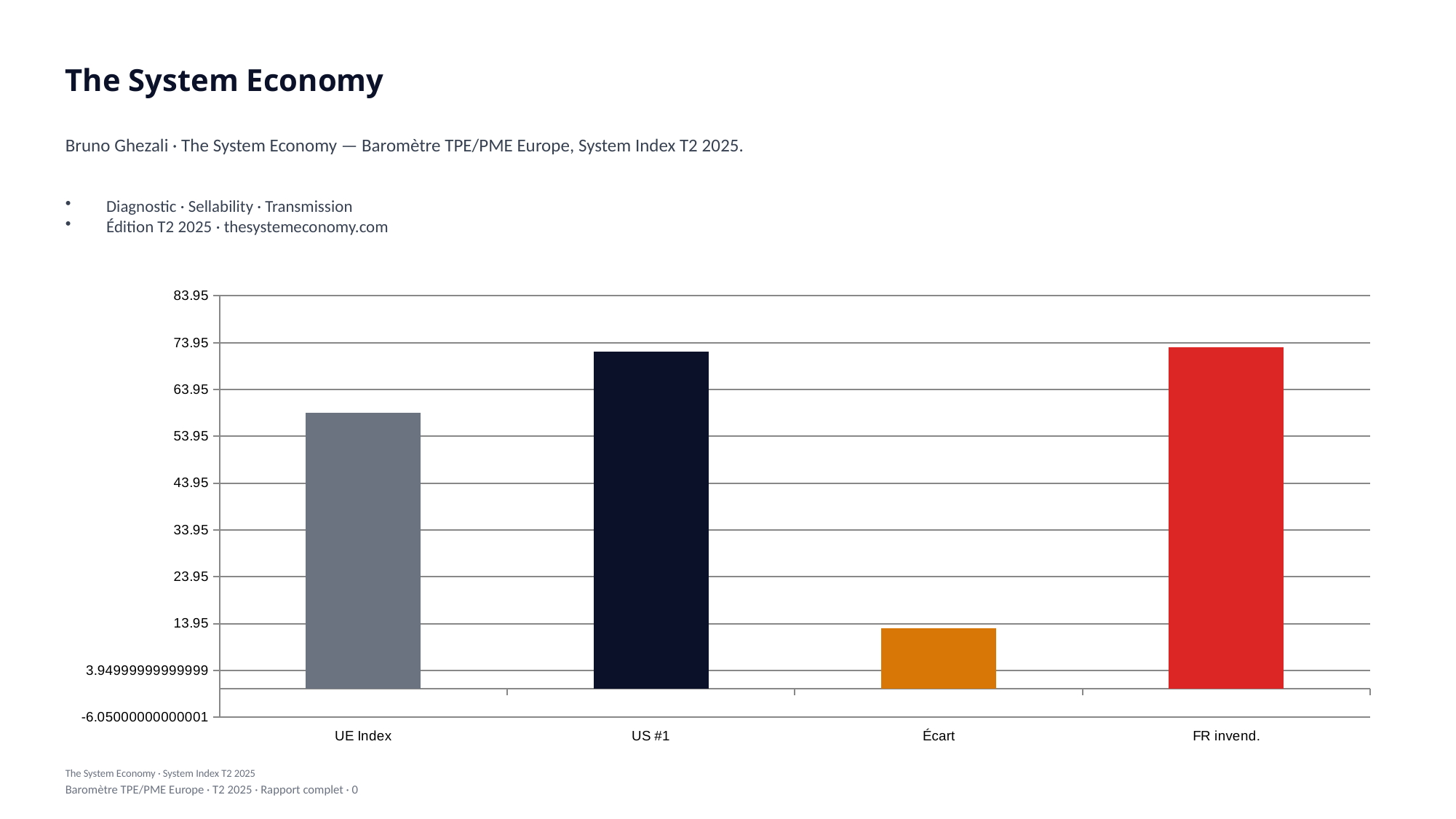
Which is larger, the value for Écart or the value for FR invend.? FR invend. Is the value for UE Index greater or less than 63.95? less Which is larger, the value for Écart or the value for UE Index? UE Index Which category has the lowest value on the chart? Écart Is the value for FR invend. greater or less than 63.95? greater Is the value for UE Index greater or less than 53.95? greater What kind of chart is shown on the slide? bar chart What colour is the bar for Écart? orange Which is larger, the value for UE Index or the value for US #1? US #1 How many categories are plotted on the chart? 4